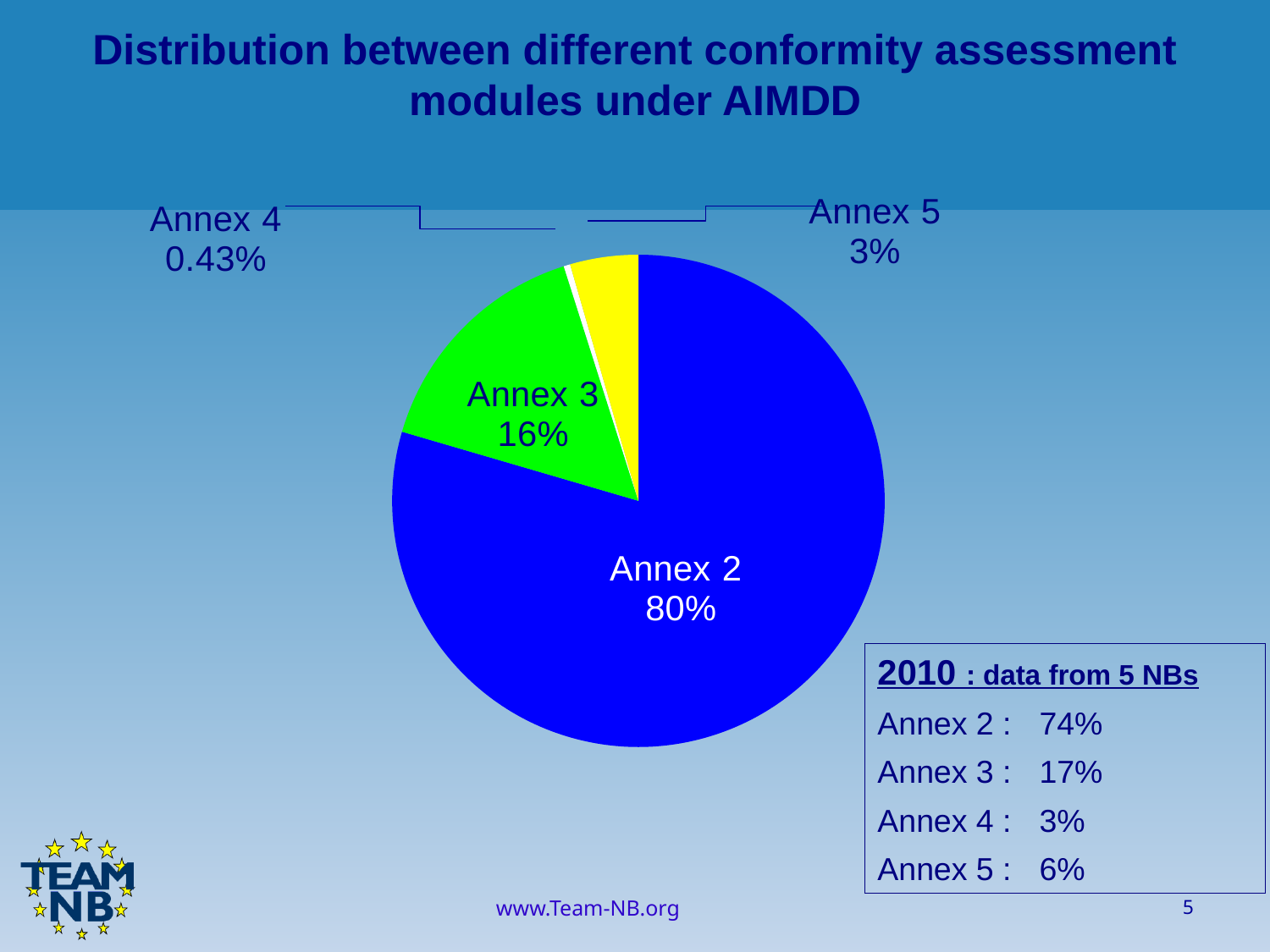
Which annex has the largest slice of the pie chart? Annex 2 What is the value shown for Annex 3 in the pie chart? 16% What is the difference between the Annex 2 and Annex 3 shares in the pie chart? 64% What colour is the Annex 3 slice in the pie chart? green How many slices does the pie chart have? 4 What is the value shown for Annex 5 in the pie chart? 3% Which annex has the smallest slice of the pie chart? Annex 4 What is the value shown for Annex 4 in the pie chart? 0.43% What share of the pie does Annex 2 represent? 80% Which is larger in the pie chart, the Annex 3 slice or the Annex 5 slice? Annex 3 What is the title of the chart on the slide? Distribution between different conformity assessment modules under AIMDD What kind of chart is shown on the slide? pie chart